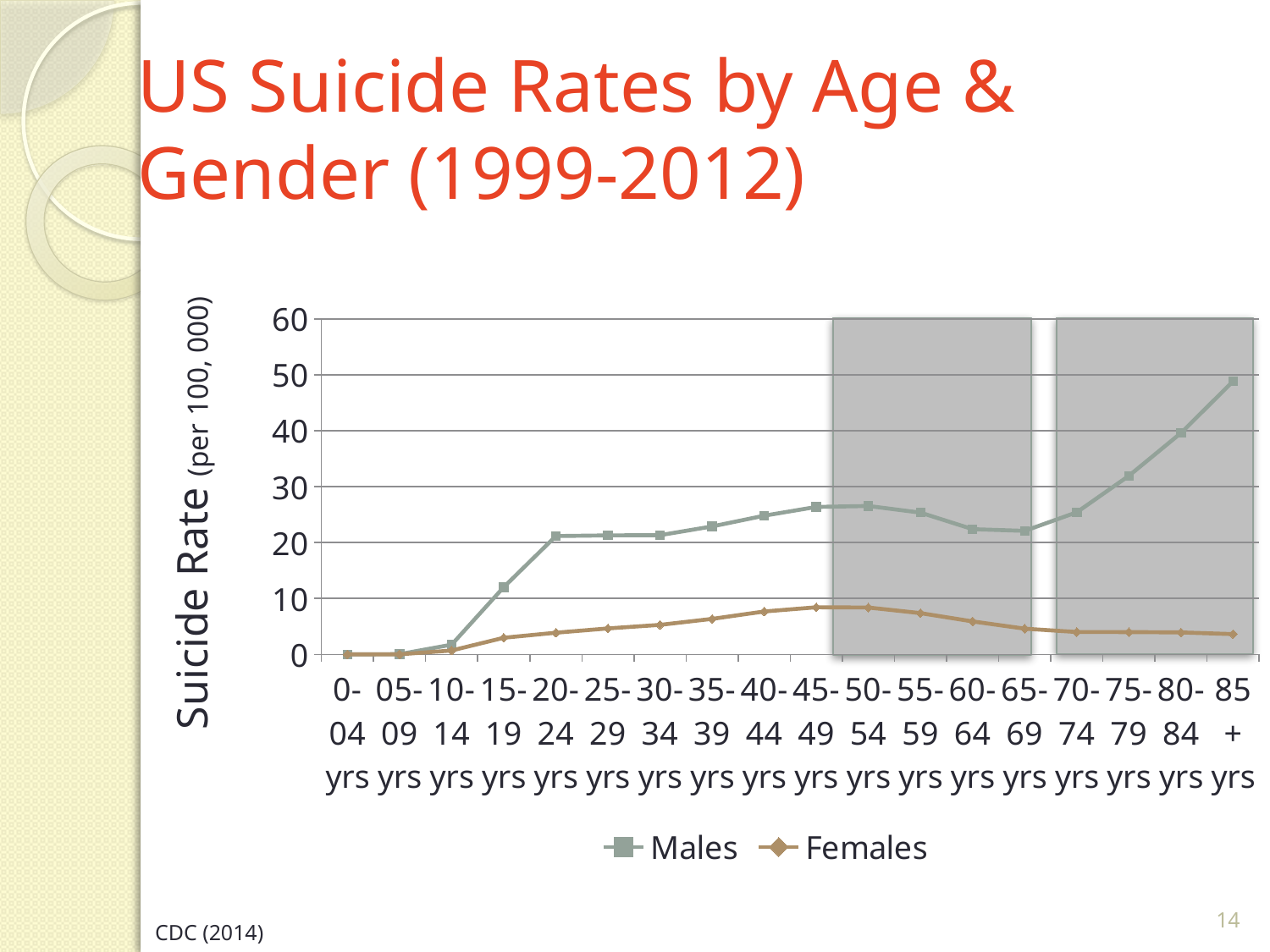
What are the two series named in the legend? Males and Females Does the Males line rise or fall from 65-69 yrs to 85+ yrs? rise Which is larger at 85+ yrs, the Males value or the Females value? Males Which age group has the lowest suicide rate for Males? 0-04 yrs What kind of chart is shown on the slide? line chart Is the Males value for 85+ yrs greater or less than 40? greater How many age groups are plotted along the x axis? 18 What is the y-axis label of the chart? Suicide Rate (per 100, 000) Which age group has the highest suicide rate for Males? 85+ yrs How many series does the legend list? 2 Is the Females value for 45-49 yrs greater or less than 10? less Is the Males value for 70-74 yrs greater or less than 20? greater